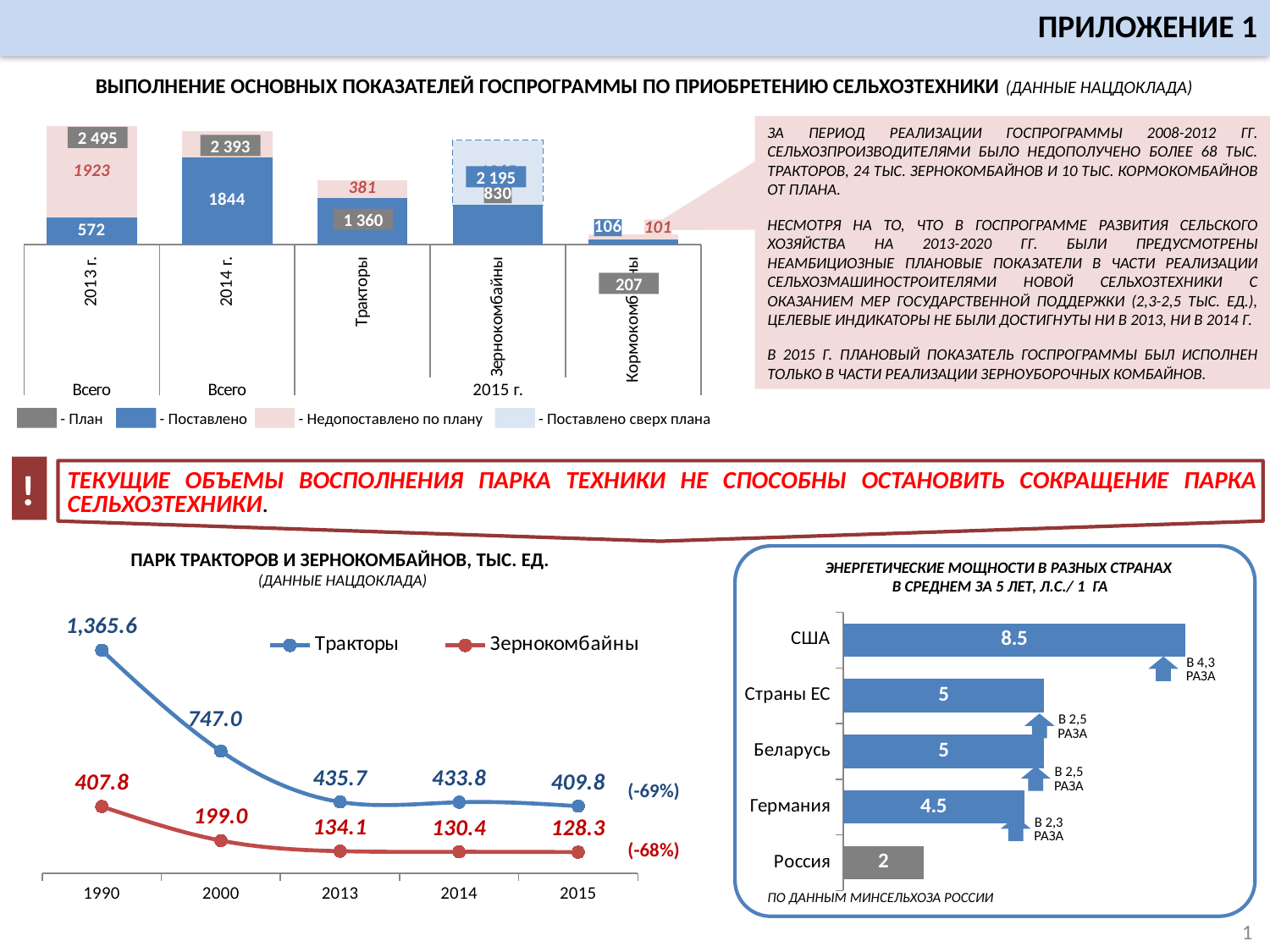
In the chart 'Парк тракторов и зернокомбайнов, тыс. ед.', what is the value for Зернокомбайны in 2015? 128.3 In the chart 'Энергетические мощности в разных странах', what kind of chart is shown? bar chart In the top-left chart 'Выполнение основных показателей госпрограммы', what is the План value for 2013 г. Всего? 2 495 In the chart 'Парк тракторов и зернокомбайнов, тыс. ед.', does the Тракторы series rise or fall from 1990 to 2015? fall In the chart 'Парк тракторов и зернокомбайнов, тыс. ед.', what is the difference between the Тракторы values for 2013 and 2015? 25.9 In the top-left chart 'Выполнение основных показателей госпрограммы', how many entries does the legend list? 4 In the chart 'Энергетические мощности в разных странах', which country has the highest value? США In the chart 'Энергетические мощности в разных странах', which country has the lowest value? Россия In the chart 'Парк тракторов и зернокомбайнов, тыс. ед.', how many series does the legend list? 2 In the chart 'Парк тракторов и зернокомбайнов, тыс. ед.', what is the value for Тракторы in 1990? 1,365.6 In the chart 'Парк тракторов и зернокомбайнов, тыс. ед.', how many years are plotted on the x axis? 5 In the chart 'Энергетические мощности в разных странах', what is the value for Германия? 4.5